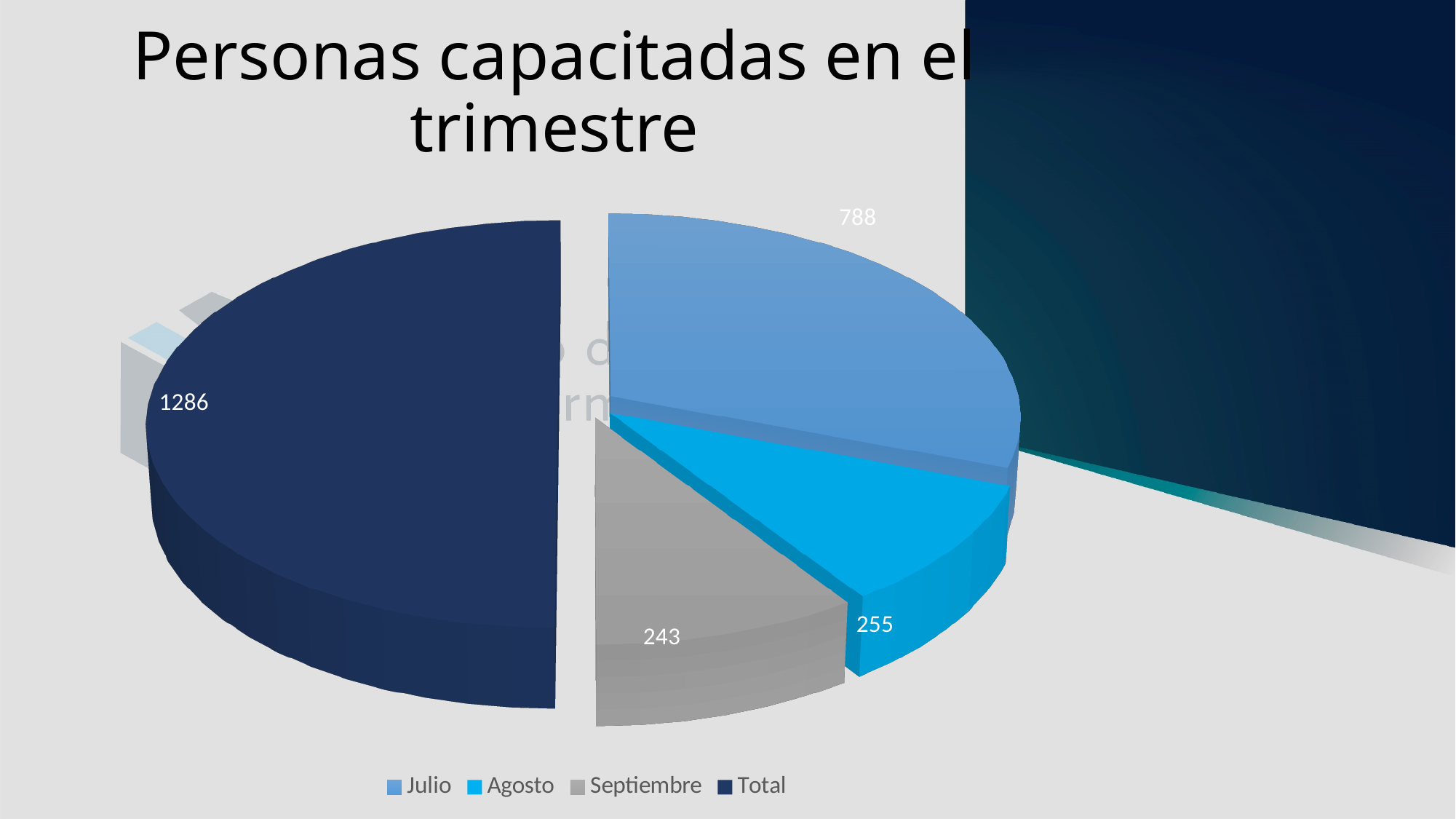
Which slice has the highest value? Total How many entries does the legend list? 4 What is the value for Julio? 788 What is the difference between the values for Julio and Agosto? 533 What is the value for Total? 1286 Which slice has the lowest value? Septiembre What is the value for Agosto? 255 What is the title of the chart? Personas capacitadas en el trimestre What is the value for Septiembre? 243 Which is larger, the value for Julio or the value for Septiembre? Julio What kind of chart is shown on the slide? pie chart How many slices does the pie chart have? 4